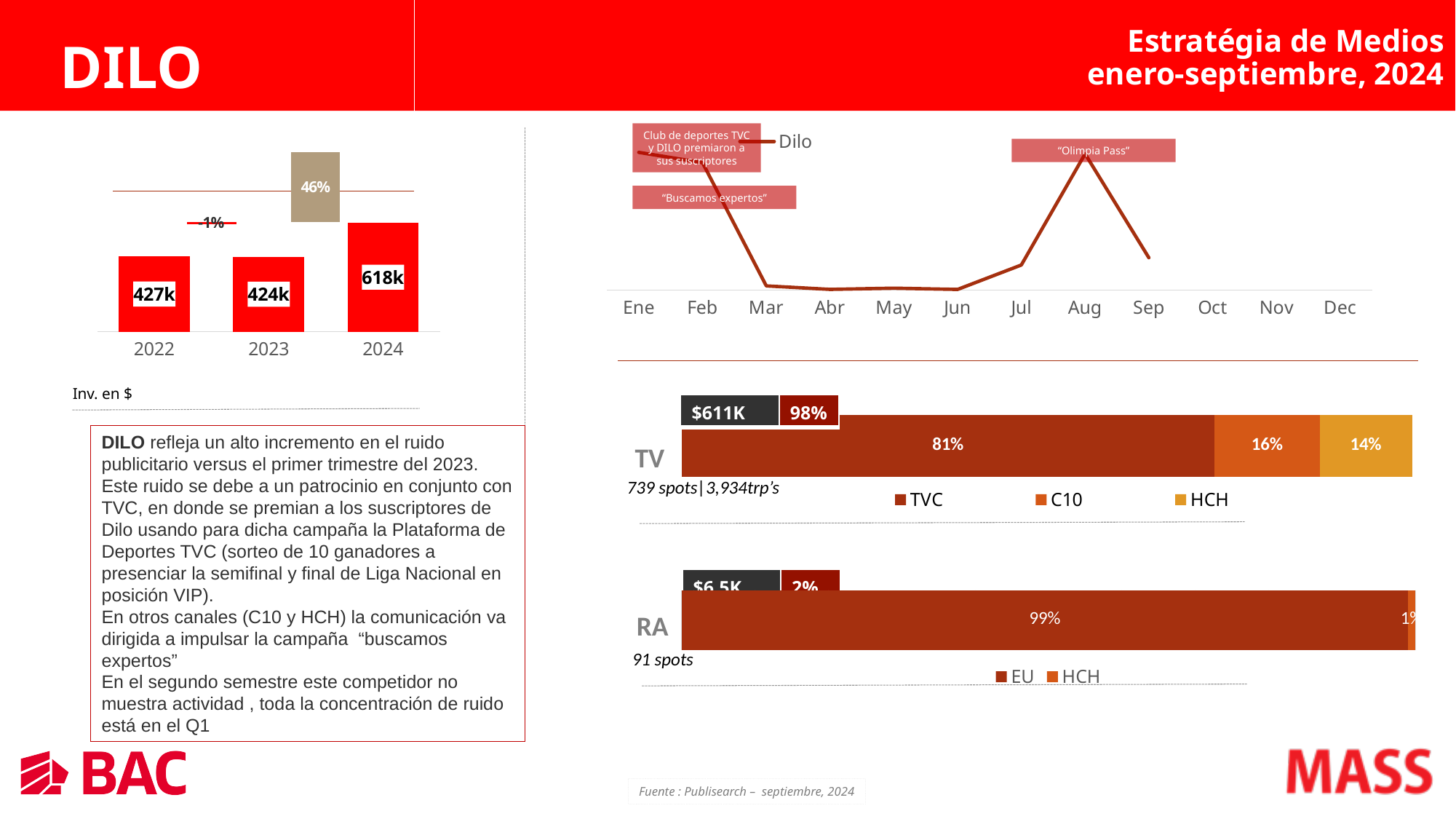
In the 'Inv. en $' bar chart, what is the difference between the 2024 and 2022 values? 191k What kind of chart is the 'Inv. en $' chart on the left? bar chart In the 'Inv. en $' bar chart, which year has the highest value? 2024 In the RA stacked bar, what share does EU have? 99% How many series does the legend of the TV stacked bar list? 3 How many months are labelled on the x axis of the 'Dilo' line chart? 12 In the 'Inv. en $' bar chart, what is the value for 2024? 618k In the TV stacked bar, which is larger, C10 or HCH? C10 In the 'Inv. en $' bar chart, which year has the lowest value? 2023 How many years are shown in the 'Inv. en $' bar chart? 3 In the TV stacked bar, what share does TVC have? 81%